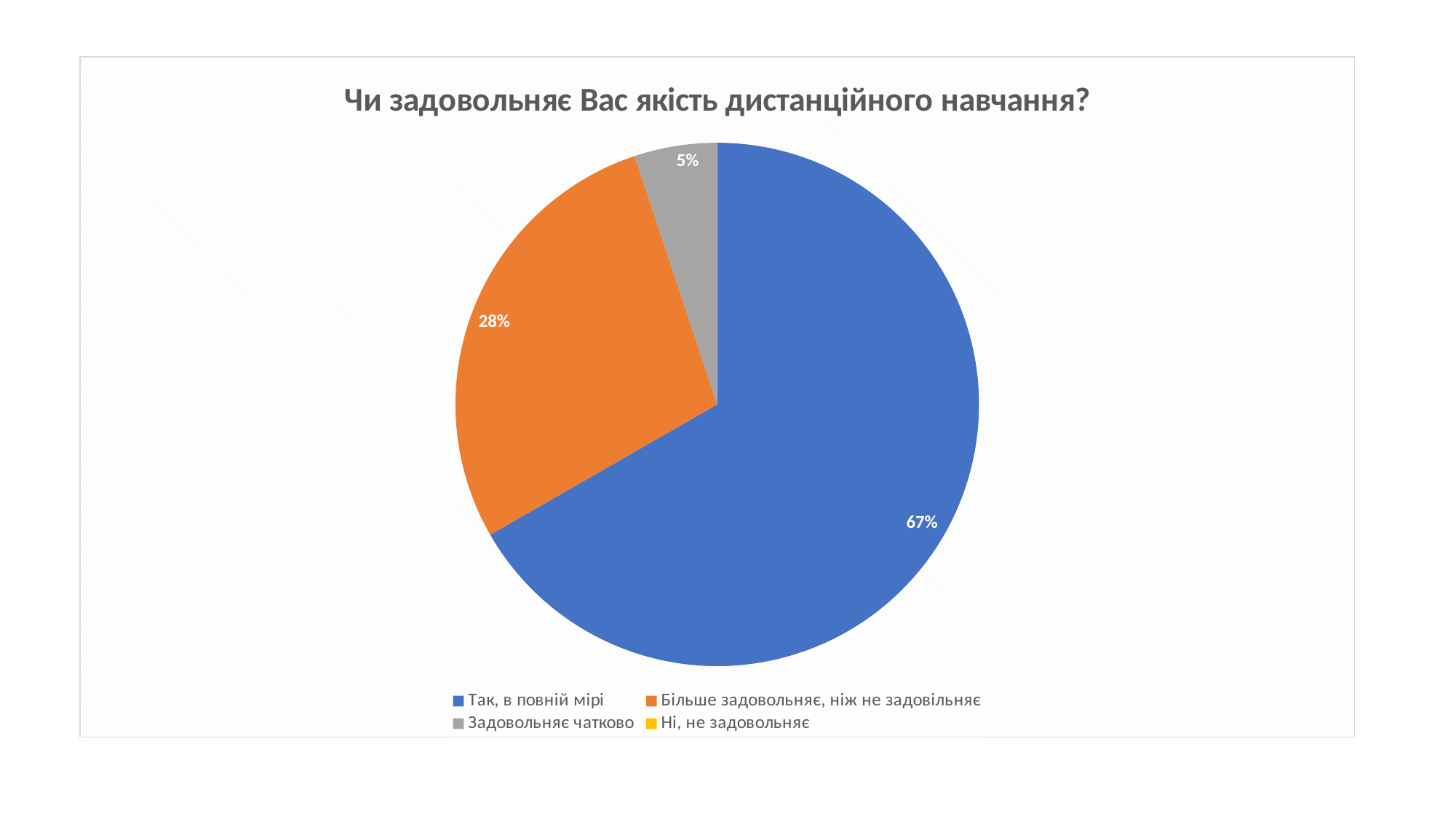
What share of the pie is labelled for "Задовольняє чатково"? 5% What is the title of the chart? Чи задовольняє Вас якість дистанційного навчання? What kind of chart is shown on the slide? pie chart Which of the labelled slices is the smallest? Задовольняє чатково What share of the pie is labelled for "Так, в повній мірі"? 67% What colour is the slice for "Так, в повній мірі"? blue By how many percentage points does "Більше задовольняє, ніж не задовільняє" exceed "Задовольняє чатково"? 23 Which is larger: the slice for "Більше задовольняє, ніж не задовільняє" or the slice for "Задовольняє чатково"? Більше задовольняє, ніж не задовільняє What share of the pie is labelled for "Більше задовольняє, ніж не задовільняє"? 28% Which category has the largest slice of the pie? Так, в повній мірі By how many percentage points does "Так, в повній мірі" exceed "Більше задовольняє, ніж не задовільняє"? 39 How many categories does the legend list? 4